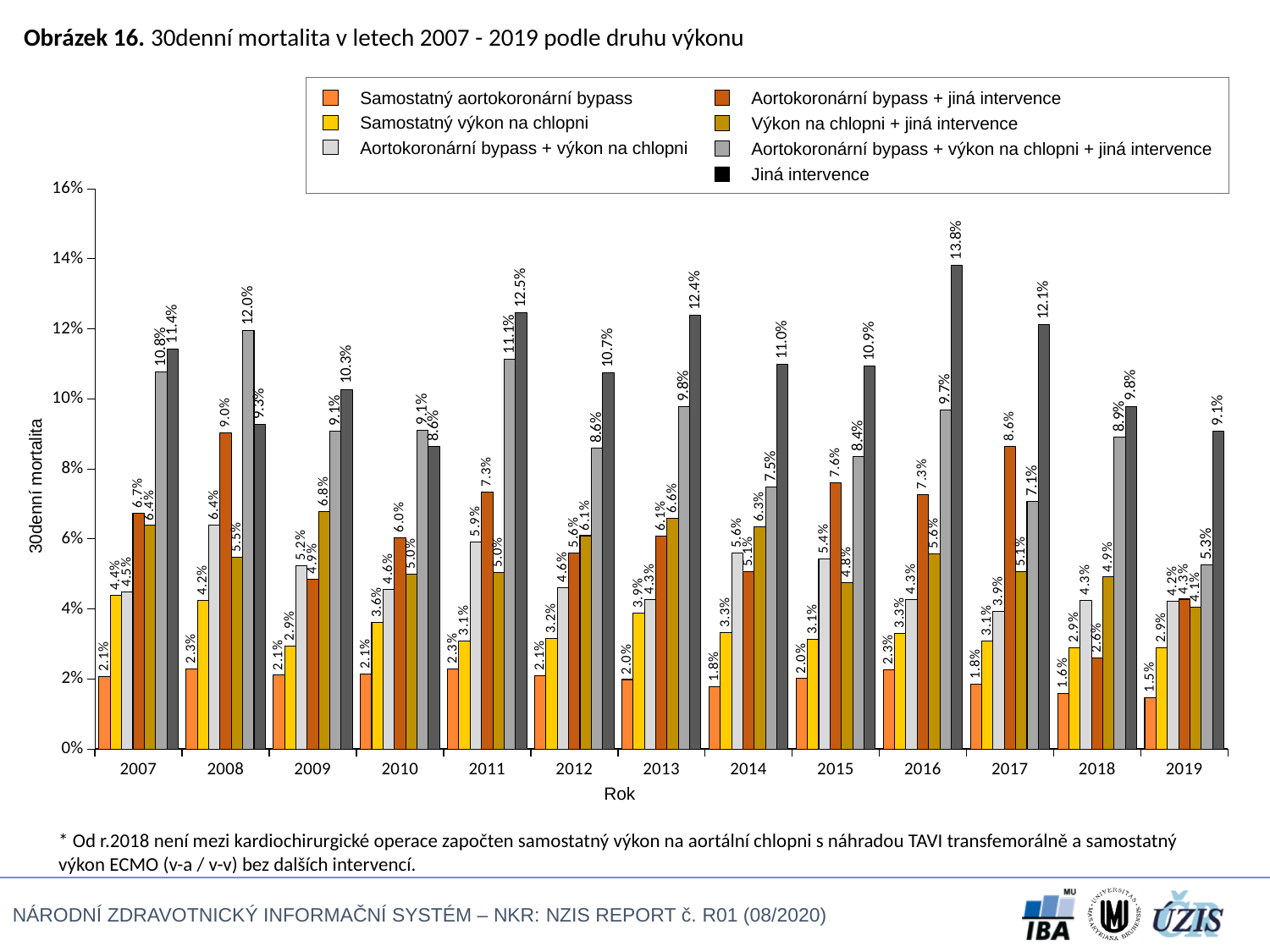
In which year is the value for 'Samostatný aortokoronární bypass' the lowest? 2019 Does the value for 'Samostatný aortokoronární bypass' rise or fall from 2016 to 2019? Fall In 2017, which is larger: 'Aortokoronární bypass + jiná intervence' or 'Aortokoronární bypass + výkon na chlopni + jiná intervence'? Aortokoronární bypass + jiná intervence What is the 30-day mortality for 'Jiná intervence' in 2016? 13.8% What kind of chart is shown on the slide? Bar chart How many years are shown on the x axis? 13 Is the value for 'Jiná intervence' in 2011 greater or less than 12%? greater What is the 30-day mortality for 'Aortokoronární bypass + výkon na chlopni' in 2008? 6.4% In which year is the value for 'Jiná intervence' the highest? 2016 How many series does the legend list? 7 What is the 30-day mortality for 'Samostatný aortokoronární bypass' in 2019? 1.5% What is the difference between 'Jiná intervence' and 'Samostatný aortokoronární bypass' in 2016? 11.5 percentage points